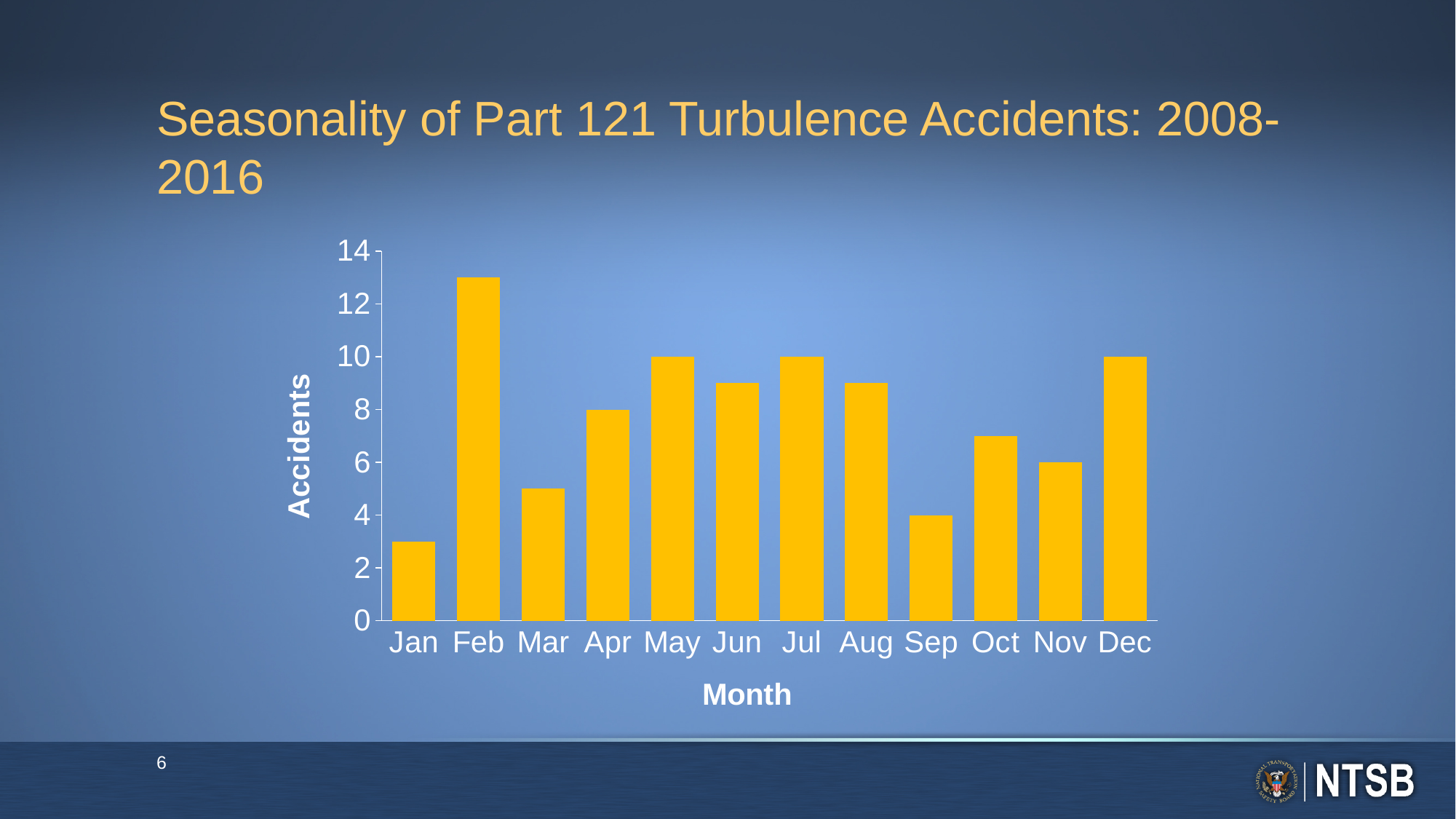
Is the value for Feb greater or less than 12? greater How many accidents are shown for Dec? 10 What is the difference between the accidents in Dec and Sep? 6 What type of chart is shown on the slide? bar chart How many accidents are shown for Sep? 4 Which month has the highest number of accidents? Feb What is the label of the y axis? Accidents How many months are shown on the x axis? 12 How many accidents are shown for Apr? 8 How many accidents are shown for Nov? 6 Is the value for Jan greater or less than 4? less Which month has the lowest number of accidents? Jan